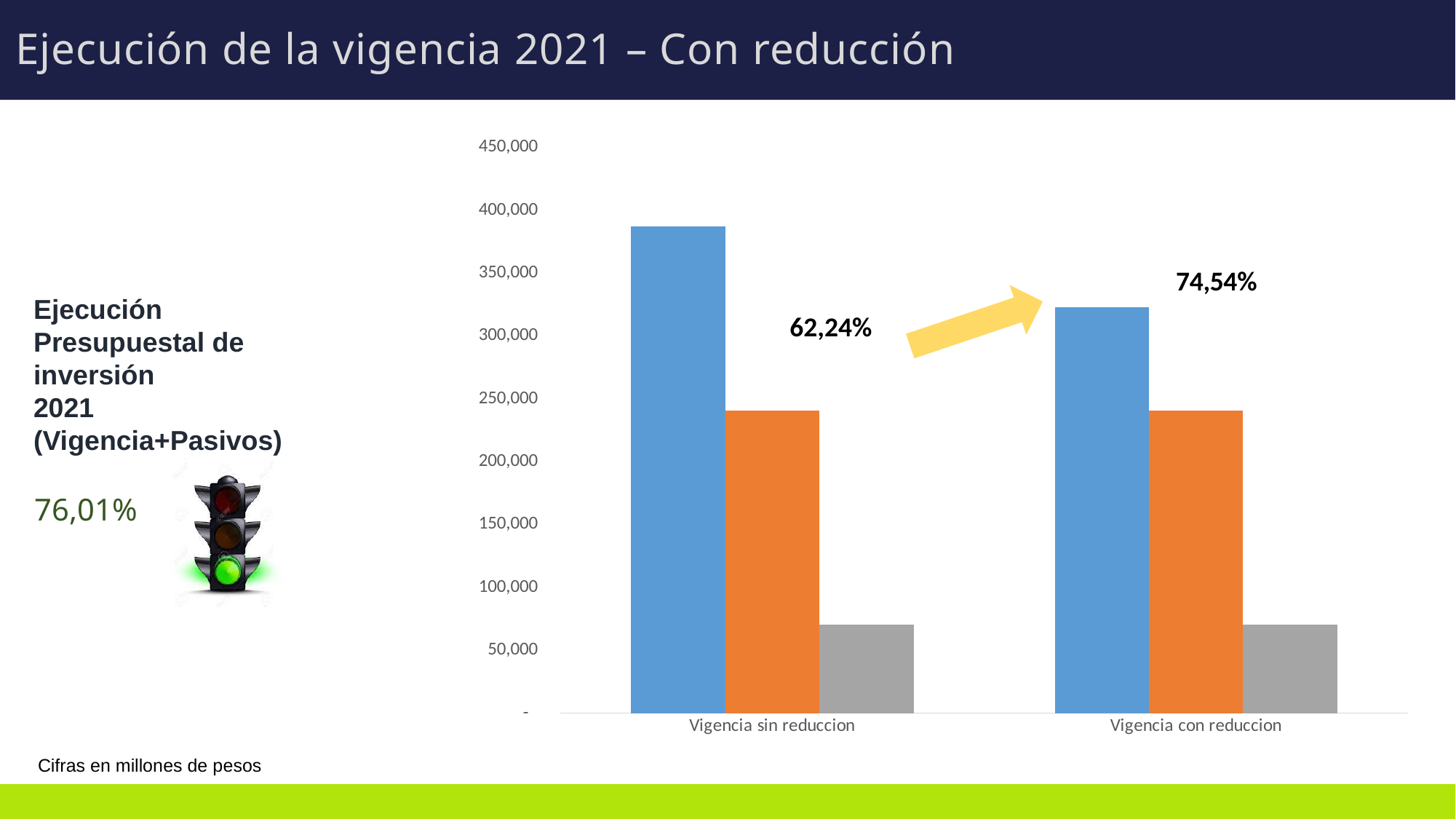
Is the value of the blue bar for Vigencia con reduccion greater or less than 350,000? less Is the value of the orange bar for Vigencia sin reduccion greater or less than 250,000? less What kind of chart is shown on the slide? bar chart Within the Vigencia sin reduccion category, which bar is the highest? the blue bar Is the value of the gray bar for Vigencia con reduccion greater or less than 100,000? less Does the blue bar rise or fall from Vigencia sin reduccion to Vigencia con reduccion? fall What percentage is printed next to the Vigencia con reduccion bars? 74,54% What are the two category labels on the x axis of the chart? Vigencia sin reduccion, Vigencia con reduccion Within the Vigencia con reduccion category, which bar is the lowest? the gray bar Which blue bar is taller: Vigencia sin reduccion or Vigencia con reduccion? Vigencia sin reduccion How many categories are shown on the x axis of the chart? 2